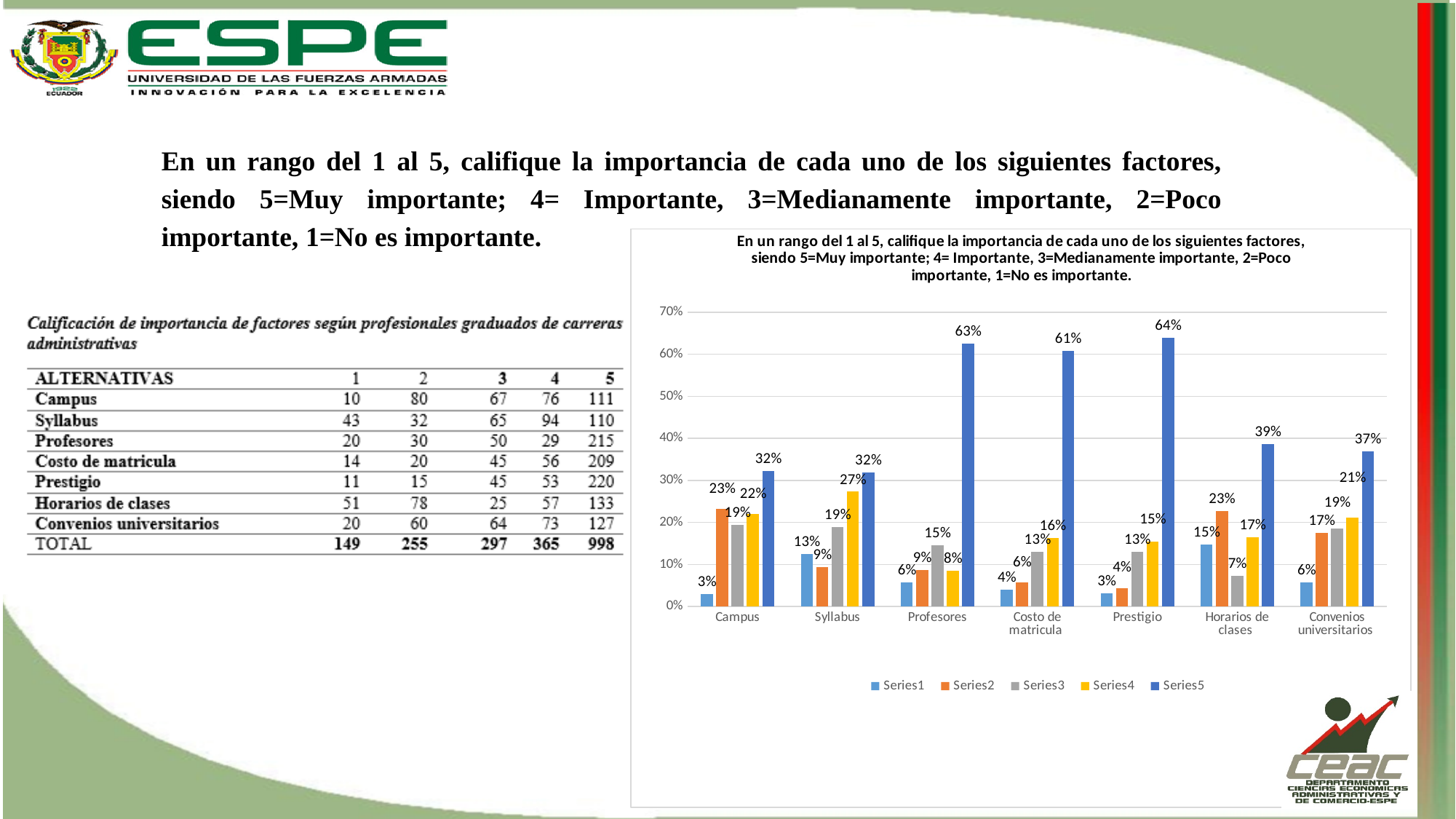
What kind of chart is shown on the slide? bar chart How many series does the legend list? 5 How many categories are shown on the x axis? 7 What is the difference between the Series5 values for Profesores and Horarios de clases? 24 percentage points What is the value of Series5 for Profesores? 63% What is the value of Series1 for Campus? 3% Is the Series5 value for Costo de matricula greater or less than 50%? greater Which is larger: the Series3 value for Campus or the Series3 value for Horarios de clases? Campus What is the value of Series4 for Convenios universitarios? 21% Which category has the lowest value for Series2? Prestigio What colour are the Series5 bars? blue Which category has the highest value for Series4? Syllabus